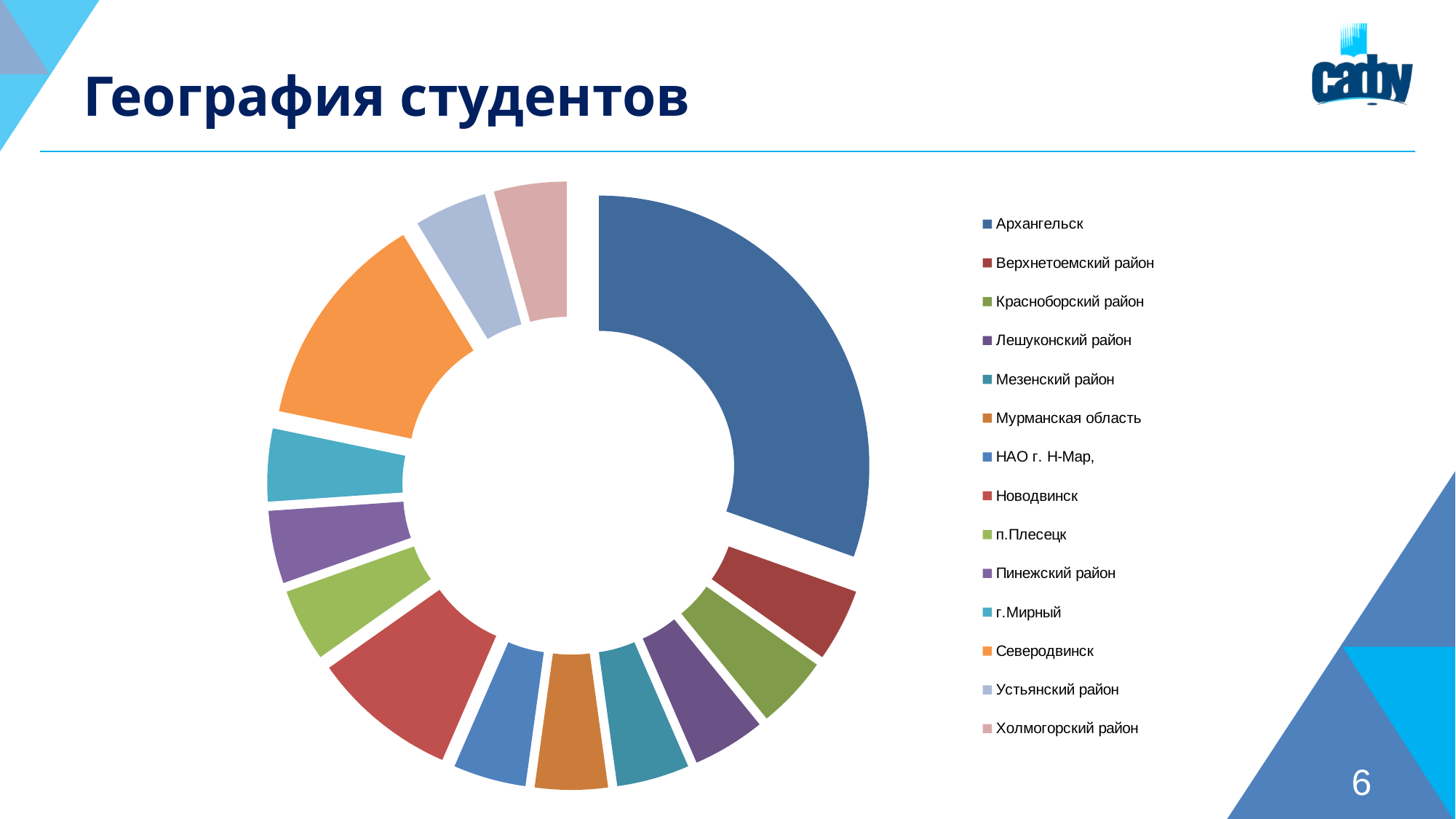
How many categories does the chart's legend list? 14 Which category has the largest slice in the chart? Архангельск Which slice is larger, Северодвинск or Мезенский район? Северодвинск Which slice is larger, Архангельск or Северодвинск? Архангельск What colour is the slice for Северодвинск in the chart? orange Which slice is larger, Новодвинск or Устьянский район? Новодвинск What kind of chart is shown on the slide? doughnut chart What is the title of the chart on the slide? География студентов Which category is the second largest slice in the chart? Северодвинск